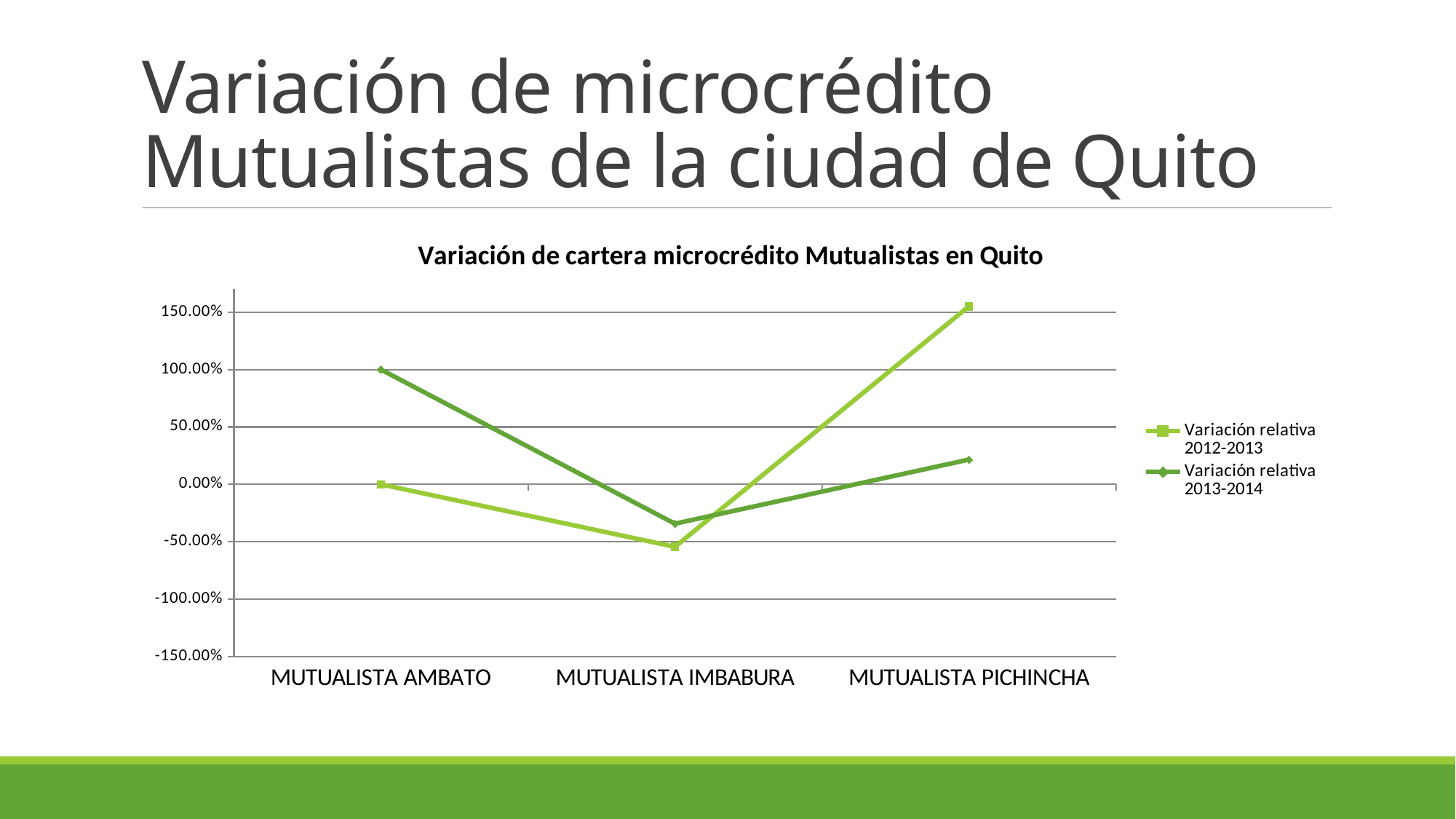
What is the value for MUTUALISTA AMBATO in the Variación relativa 2012-2013 series? 0.00% How many series does the legend list? 2 For MUTUALISTA PICHINCHA, which series has the larger value: Variación relativa 2012-2013 or Variación relativa 2013-2014? Variación relativa 2012-2013 What kind of chart is shown on the slide? Line chart Is the value for MUTUALISTA PICHINCHA in the Variación relativa 2013-2014 series greater or less than 50.00%? less What is the value for MUTUALISTA AMBATO in the Variación relativa 2013-2014 series? 100.00% Which mutualista has the highest value in the Variación relativa 2013-2014 series? MUTUALISTA AMBATO Is the value for MUTUALISTA PICHINCHA in the Variación relativa 2012-2013 series greater or less than 100.00%? greater Which mutualista has the highest value in the Variación relativa 2012-2013 series? MUTUALISTA PICHINCHA What is the title of the chart? Variación de cartera microcrédito Mutualistas en Quito How many mutualistas (categories) are shown on the x axis? 3 Which mutualista has the lowest value in the Variación relativa 2013-2014 series? MUTUALISTA IMBABURA